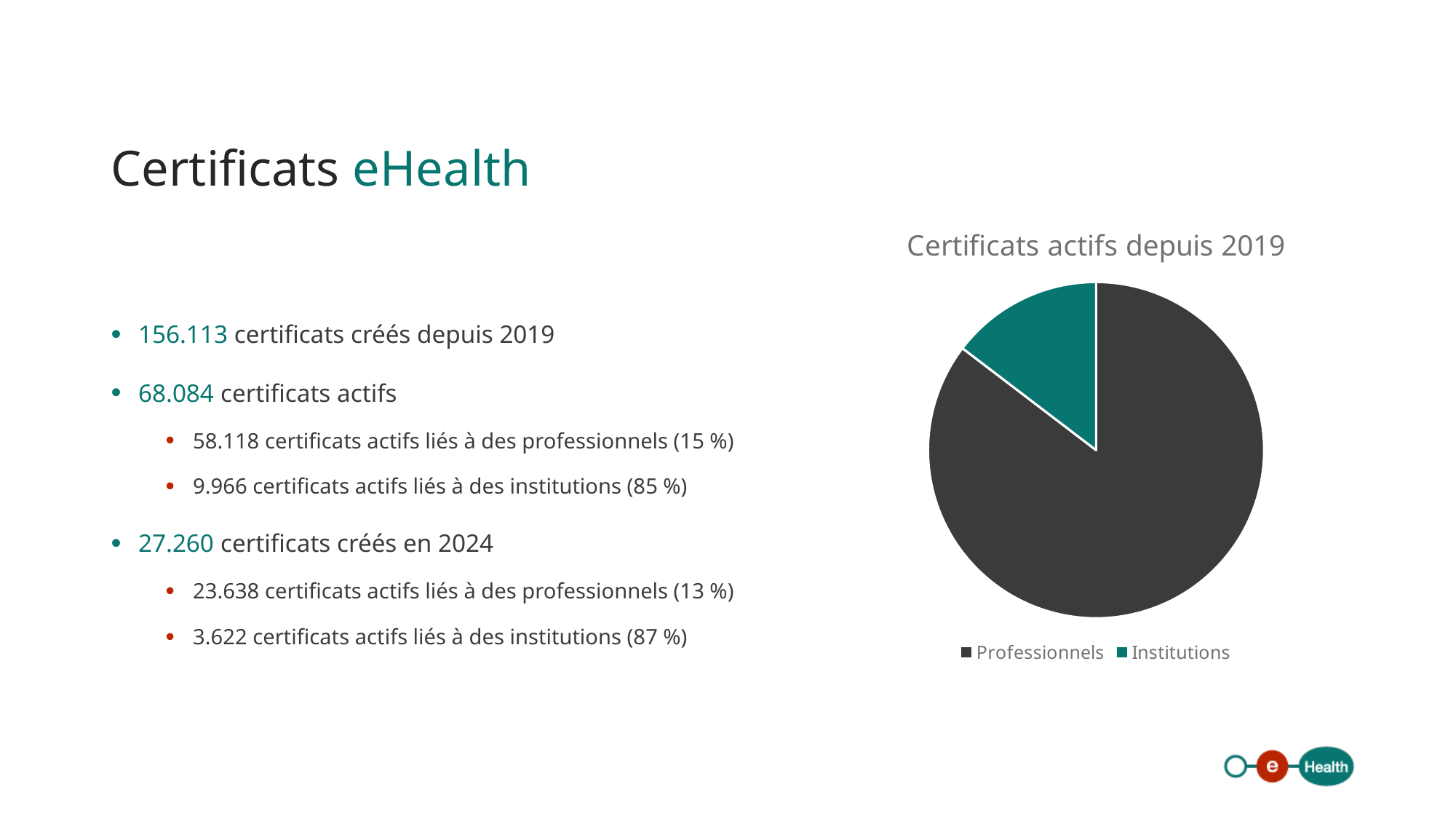
Which category has the largest slice in the pie chart? Professionnels Which category has the smallest slice in the pie chart? Institutions In the pie chart, which slice is larger: Professionnels or Institutions? Professionnels What kind of chart is shown on the slide? Pie chart How many slices does the pie chart have? 2 Which colour represents Institutions in the pie chart? Teal Does the Professionnels slice take up more or less than half of the pie chart? More How many entries does the legend of the pie chart list? 2 What is the title of the pie chart? Certificats actifs depuis 2019